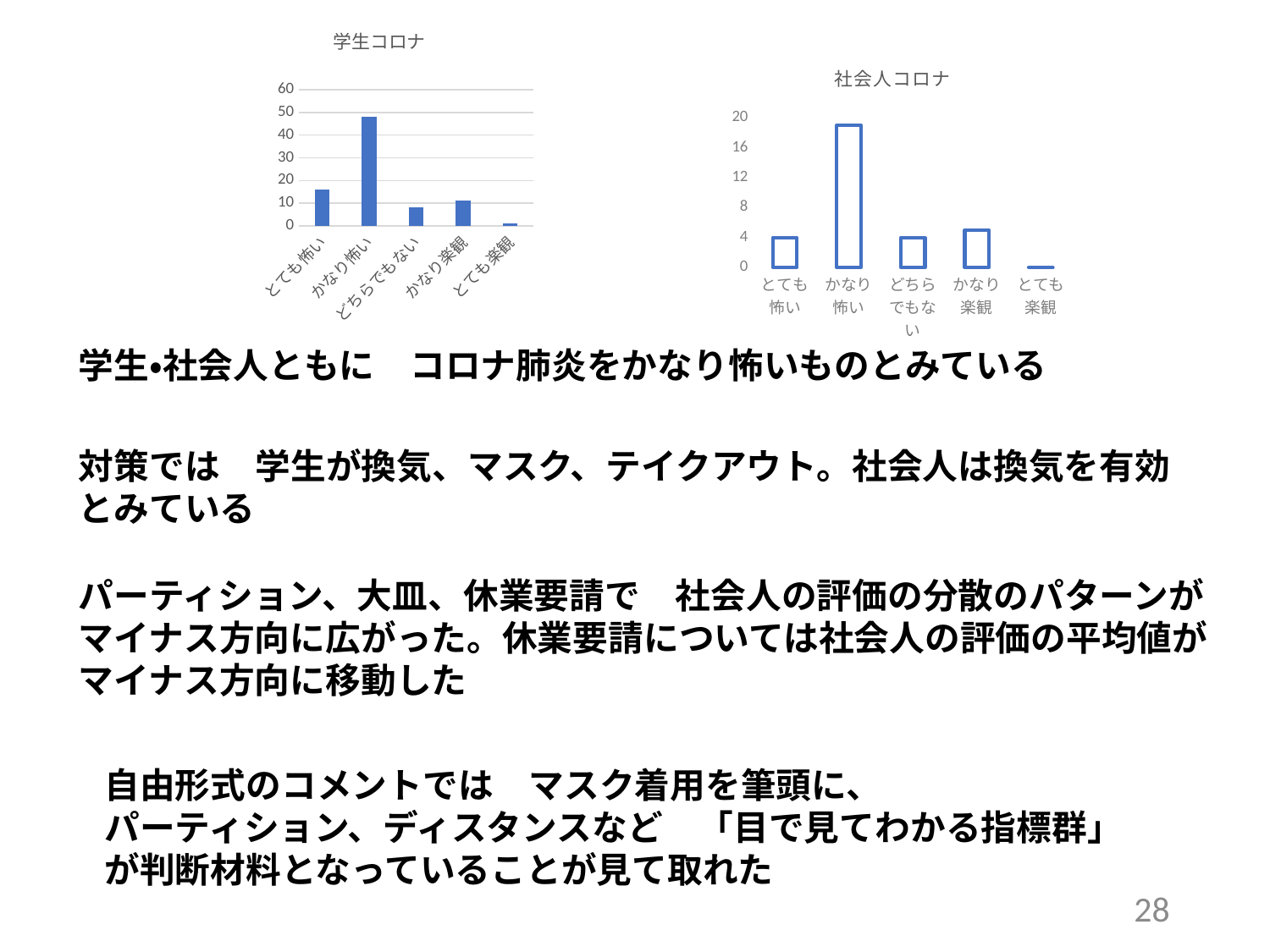
How many categories are shown in the 学生コロナ chart? 5 In the 学生コロナ chart, which category has the lowest value? とても楽観 In the 社会人コロナ chart, is the value for とても楽観 greater or less than 4? less In the 学生コロナ chart, which is larger, とても怖い or かなり楽観? とても怖い What type of chart is the 学生コロナ chart? bar chart In the 社会人コロナ chart, which category has the lowest value? とても楽観 In the 学生コロナ chart, which category has the highest value? かなり怖い What is the title of the chart on the right side of the slide? 社会人コロナ In the 学生コロナ chart, is the value for かなり怖い greater or less than 40? greater In the 社会人コロナ chart, which category has the highest value? かなり怖い In the 社会人コロナ chart, is the value for かなり怖い greater or less than 16? greater